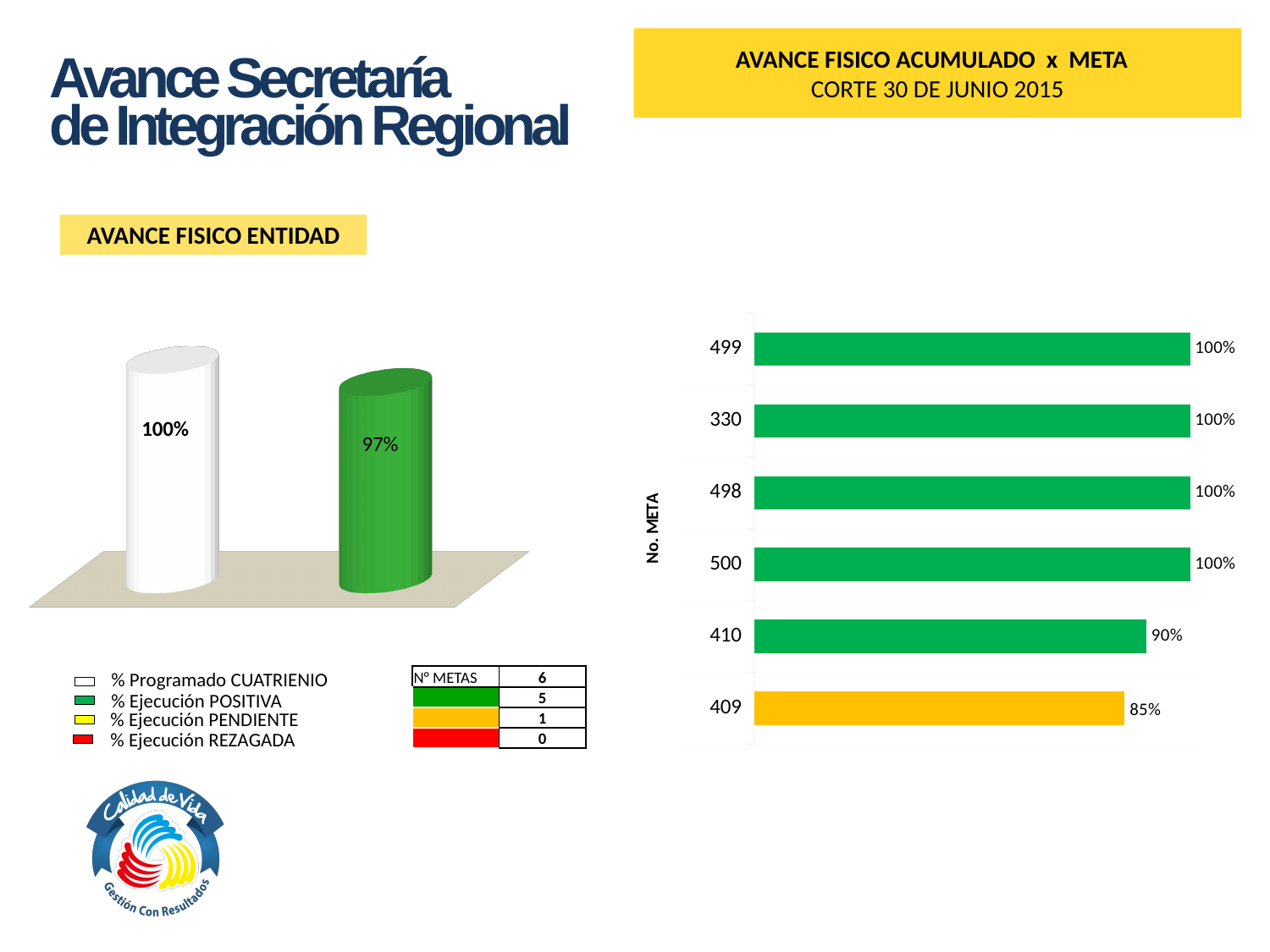
In the AVANCE FISICO ACUMULADO x META chart, what is the value for meta 499? 100% In the AVANCE FISICO ENTIDAD chart, what is the value for % Ejecución POSITIVA? 97% In the AVANCE FISICO ACUMULADO x META chart, what is the difference between the values for meta 410 and meta 409? 5% In the AVANCE FISICO ACUMULADO x META chart, which is larger, the value for meta 500 or the value for meta 410? 500 In the AVANCE FISICO ACUMULADO x META chart, what is the value for meta 409? 85% How many metas are shown in the AVANCE FISICO ACUMULADO x META chart? 6 In the AVANCE FISICO ACUMULADO x META chart, which meta has the lowest value? 409 What kind of chart is the AVANCE FISICO ACUMULADO x META chart? bar chart In the AVANCE FISICO ENTIDAD chart, what is the value for % Programado CUATRIENIO? 100% In the AVANCE FISICO ACUMULADO x META chart, how many metas have a value of 100%? 4 How many entries does the legend of the AVANCE FISICO ENTIDAD chart list? 4 In the AVANCE FISICO ACUMULADO x META chart, what is the value for meta 410? 90%